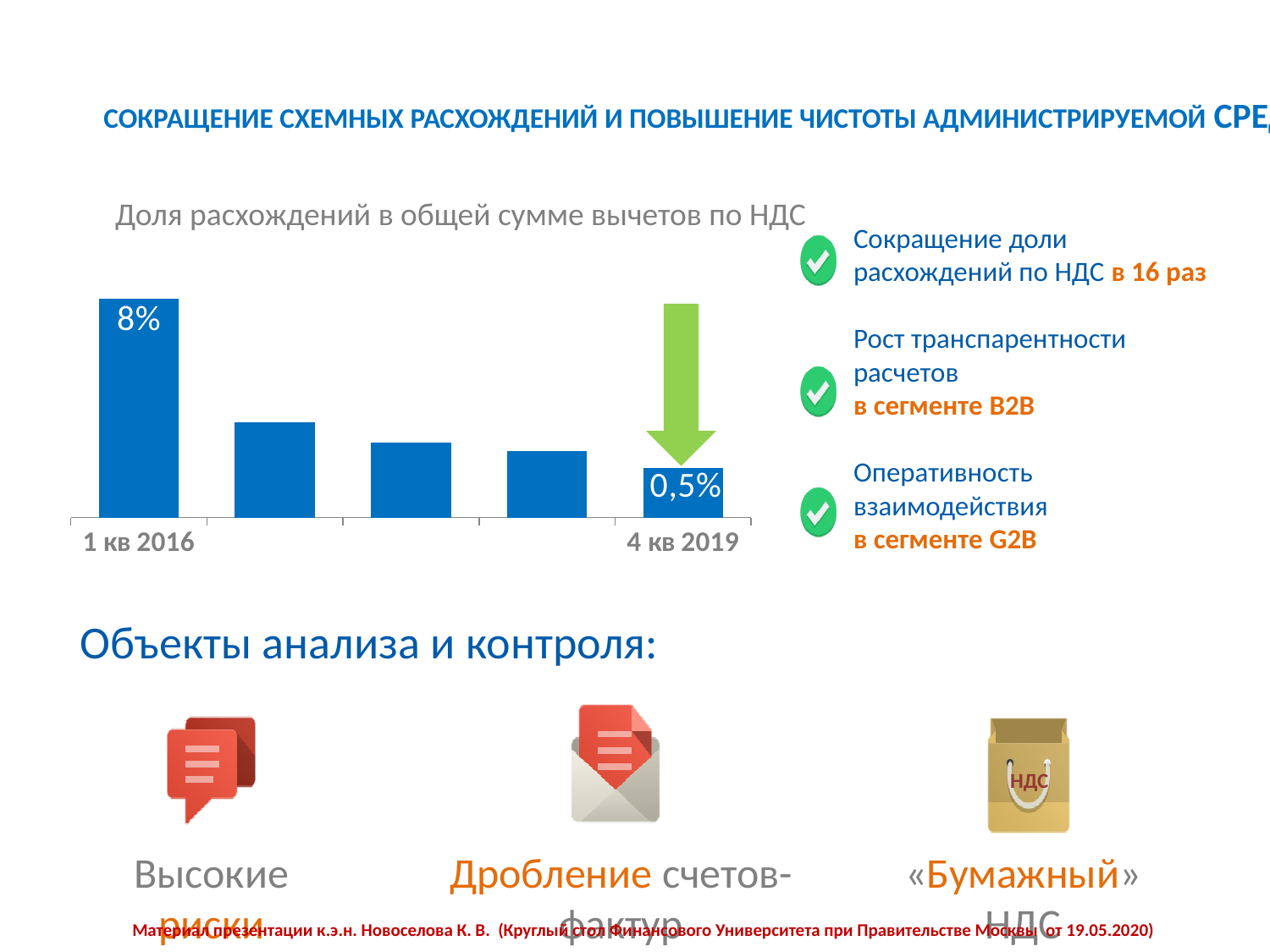
What colour are the bars in the chart? blue Which is larger, the value for 1 кв 2016 or the value for 4 кв 2019? 1 кв 2016 What is the value for 4 кв 2019 in the chart? 0,5% What kind of chart is shown on the slide? bar chart Do the values rise or fall from 1 кв 2016 to 4 кв 2019? fall What is the value for 1 кв 2016 in the chart? 8% Which labelled period has the highest value in the chart? 1 кв 2016 What is the title of the chart? Доля расхождений в общей сумме вычетов по НДС What is the difference between the values for 1 кв 2016 and 4 кв 2019? 7,5% How many bars are plotted in the chart? 5 Which labelled period has the lowest value in the chart? 4 кв 2019